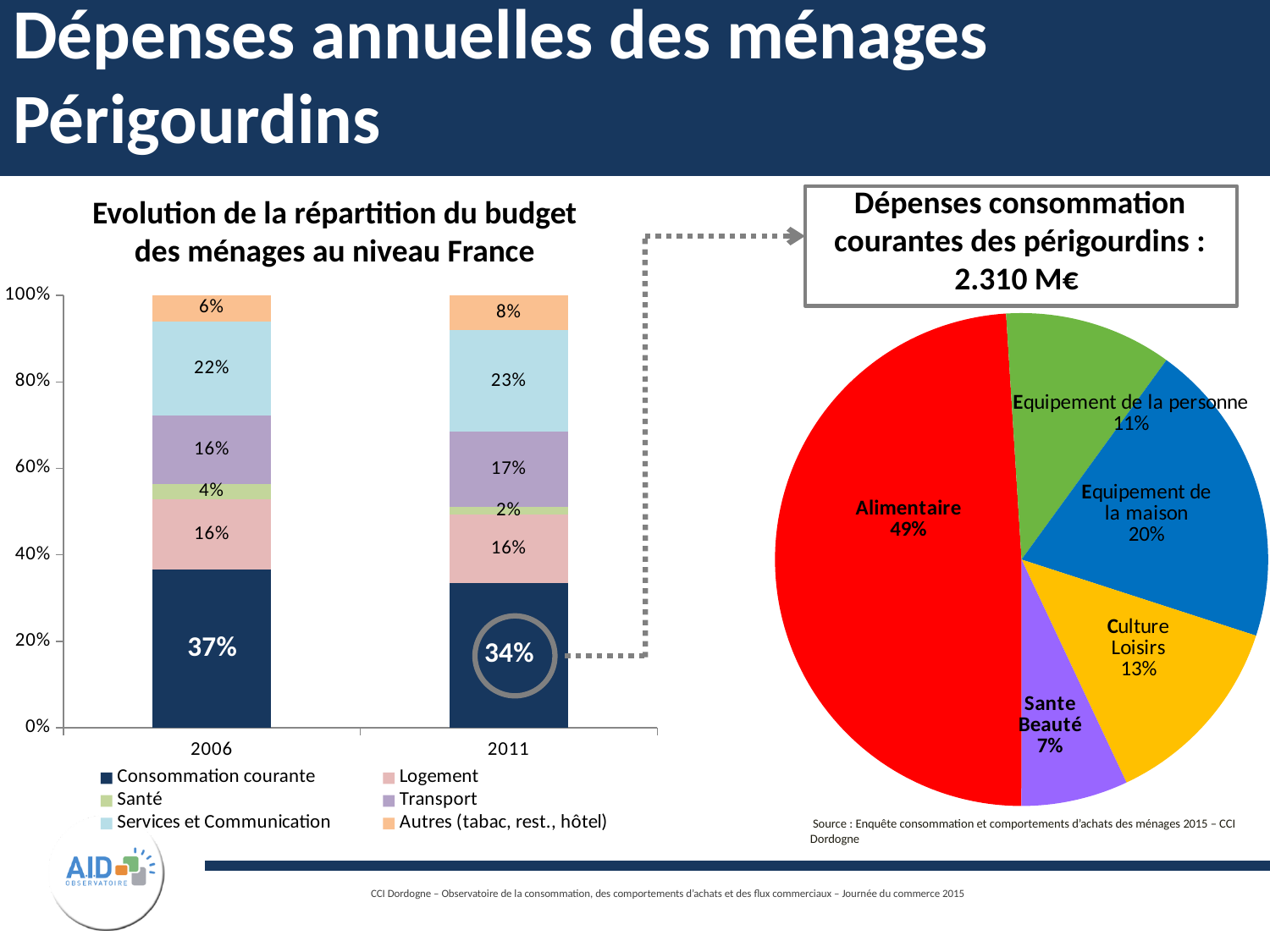
In the bar chart 'Evolution de la répartition du budget des ménages au niveau France', what is the value for Services et Communication in 2011? 23% In the bar chart 'Evolution de la répartition du budget des ménages au niveau France', which series has the smallest share in 2011? Santé In the bar chart 'Evolution de la répartition du budget des ménages au niveau France', what is the value for Consommation courante in 2011? 34% In the pie chart 'Dépenses consommation courantes des périgourdins', how many categories are shown? 5 In the bar chart 'Evolution de la répartition du budget des ménages au niveau France', by how many percentage points did Consommation courante change from 2006 to 2011? 3 percentage points lower (37% to 34%) In the bar chart 'Evolution de la répartition du budget des ménages au niveau France', which series has the largest share in 2006? Consommation courante In the pie chart 'Dépenses consommation courantes des périgourdins', which category has the smallest share? Sante Beauté In the pie chart 'Dépenses consommation courantes des périgourdins', what share does Alimentaire represent? 49% What kind of chart is the chart on the right titled 'Dépenses consommation courantes des périgourdins : 2.310 M€'? Pie chart In the bar chart 'Evolution de la répartition du budget des ménages au niveau France', what is the value for Santé in 2006? 4% In the bar chart 'Evolution de la répartition du budget des ménages au niveau France', how many series does the legend list? 6 In the bar chart 'Evolution de la répartition du budget des ménages au niveau France', is the share of Autres (tabac, rest., hôtel) larger in 2006 or in 2011? 2011